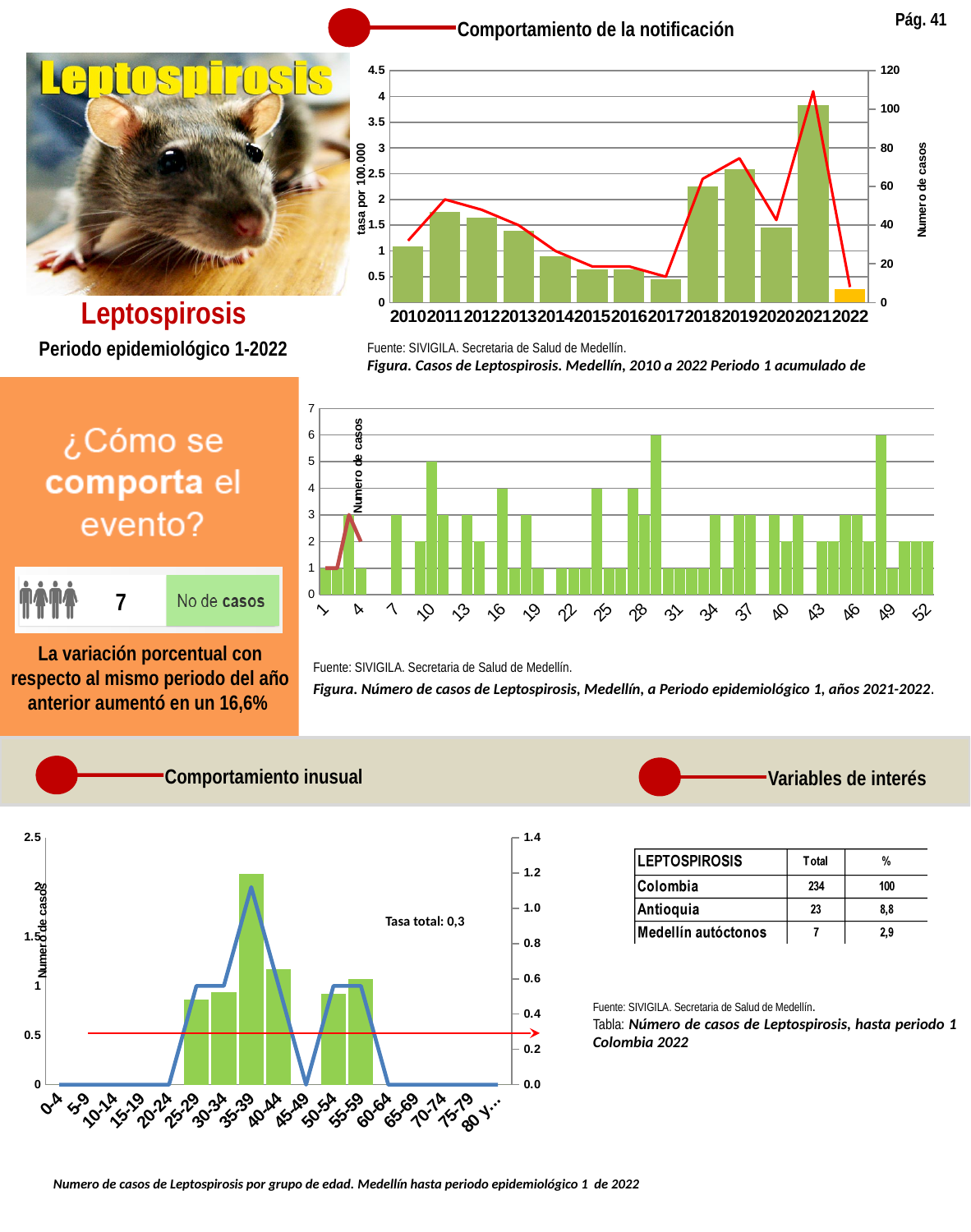
In the top-right chart 'Casos de Leptospirosis. Medellín, 2010 a 2022', is the bar for 2017 greater or less than 1 on the left axis? less In the top-right chart 'Casos de Leptospirosis. Medellín, 2010 a 2022', how many years are shown on the x axis? 13 In the top-right chart 'Casos de Leptospirosis. Medellín, 2010 a 2022', is the bar for 2021 greater or less than 3 on the left axis? greater In the top-right chart 'Casos de Leptospirosis. Medellín, 2010 a 2022', which year has the shortest bar? 2022 In the bottom-left chart of cases by age group, how many age groups are shown on the x axis? 17 In the top-right chart 'Casos de Leptospirosis. Medellín, 2010 a 2022', which year has the tallest bar? 2021 What value does the 'Tasa total' annotation show in the bottom-left chart of cases by age group? 0,3 In the top-right chart 'Casos de Leptospirosis. Medellín, 2010 a 2022', which bar is taller, 2011 or 2014? 2011 In the middle chart 'Número de casos de Leptospirosis, Medellín, a Periodo epidemiológico 1, años 2021-2022', is the bar for week 10 greater or less than 4? greater What is the left axis title of the top-right chart 'Casos de Leptospirosis. Medellín, 2010 a 2022'? tasa por 100.000 What kind of chart is the top-right chart titled 'Casos de Leptospirosis. Medellín, 2010 a 2022'? bar chart with a line In the bottom-left chart of cases by age group, which age group has the tallest bar? 35-39